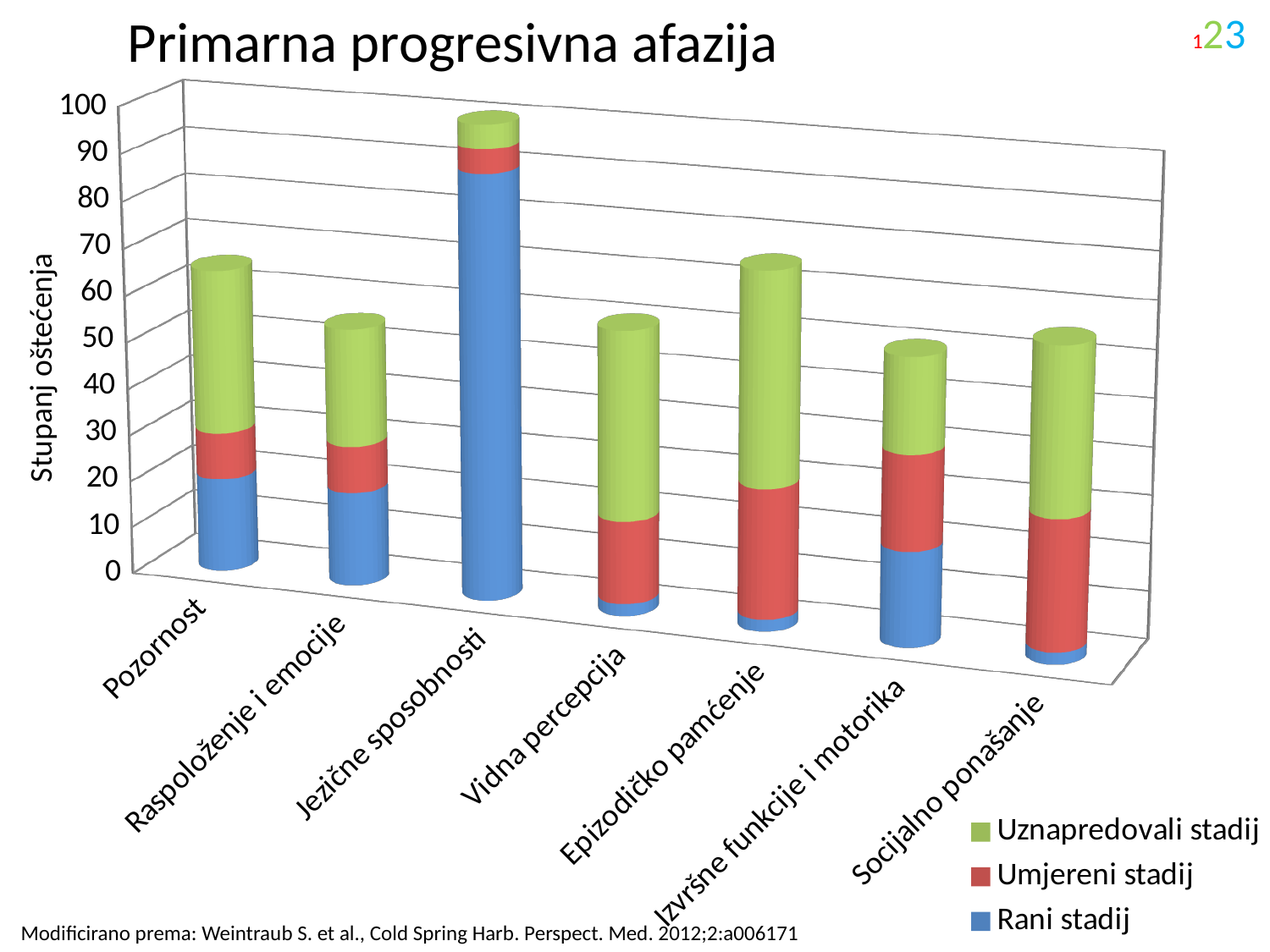
Which has the larger Umjereni stadij value, Epizodičko pamćenje or Pozornost? Epizodičko pamćenje Is the total stacked value for Jezične sposobnosti greater or less than 80? greater How many categories are shown on the x axis of the chart? 7 What is the title of the chart? Primarna progresivna afazija Is the Rani stadij value for Socijalno ponašanje greater or less than 10? less What is the label of the vertical axis? Stupanj oštećenja Is the total stacked value for Pozornost greater or less than 50? greater What kind of chart is shown on the slide? Stacked bar chart Which category has the highest total stacked bar? Jezične sposobnosti Which has the larger Rani stadij value, Jezične sposobnosti or Pozornost? Jezične sposobnosti Which has the larger total stacked bar, Jezične sposobnosti or Pozornost? Jezične sposobnosti How many series does the chart legend list? 3